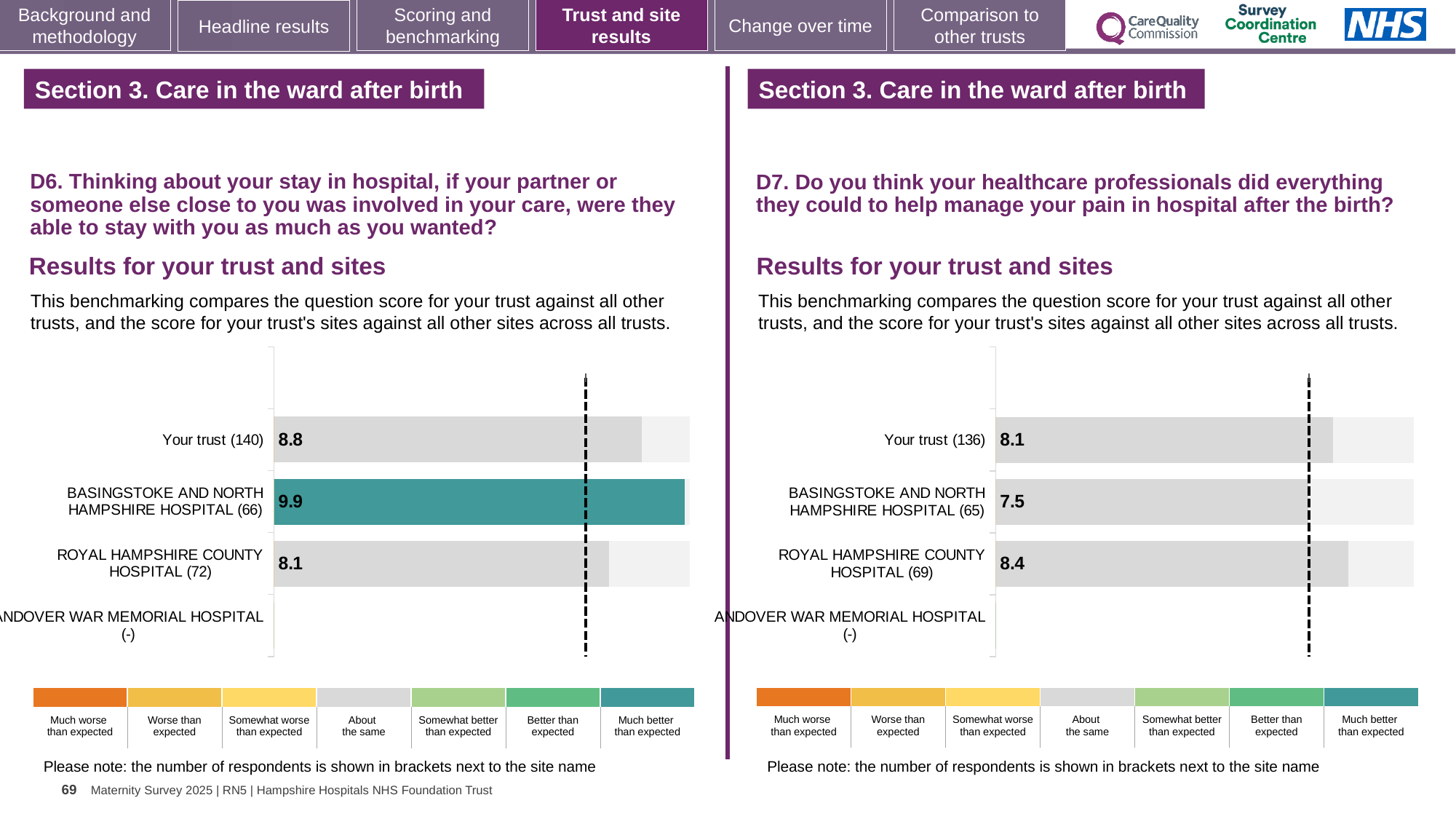
In the D6 chart on the left, which bar is coloured teal rather than grey? BASINGSTOKE AND NORTH HAMPSHIRE HOSPITAL (66) In the D7 chart on the right, which is larger: the score for Your trust (136) or for ROYAL HAMPSHIRE COUNTY HOSPITAL (69)? ROYAL HAMPSHIRE COUNTY HOSPITAL (69) In the D7 chart on the right, what is the score for Your trust (136)? 8.1 In the D7 chart on the right, which site has the lowest score? BASINGSTOKE AND NORTH HAMPSHIRE HOSPITAL (65) In the D6 chart on the left, what is the score for ROYAL HAMPSHIRE COUNTY HOSPITAL (72)? 8.1 What kind of chart is used in the D6 chart on the left? Bar chart In the D6 chart on the left, what is the score for Your trust (140)? 8.8 In the D7 chart on the right, what is the score for ROYAL HAMPSHIRE COUNTY HOSPITAL (69)? 8.4 In the D7 chart on the right, what is the score for BASINGSTOKE AND NORTH HAMPSHIRE HOSPITAL (65)? 7.5 In the D6 chart on the left, what is the difference between the scores for BASINGSTOKE AND NORTH HAMPSHIRE HOSPITAL (66) and ROYAL HAMPSHIRE COUNTY HOSPITAL (72)? 1.8 In the D6 chart on the left, what is the score for BASINGSTOKE AND NORTH HAMPSHIRE HOSPITAL (66)? 9.9 In the D6 chart on the left, which site has the highest score? BASINGSTOKE AND NORTH HAMPSHIRE HOSPITAL (66)